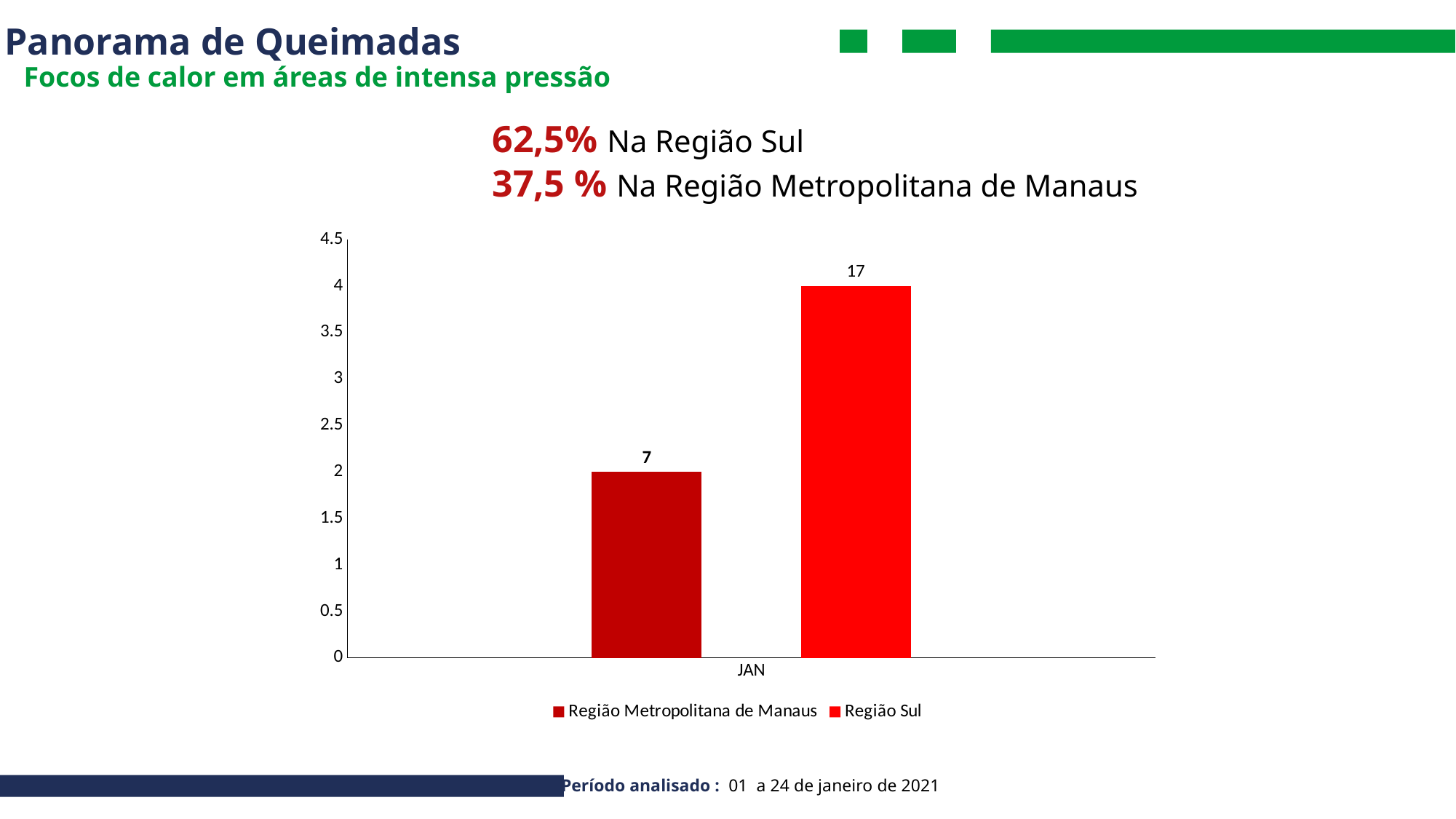
What is the highest value shown on the y axis? 4.5 What is the data label for Região Metropolitana de Manaus in JAN? 7 Which series has the higher bar in JAN? Região Sul What is the data label for Região Sul in JAN? 17 Is the bar for Região Sul larger or smaller than the bar for Região Metropolitana de Manaus? larger How many series does the legend list? 2 How many categories are shown on the x axis? 1 What is the label of the category on the x axis? JAN What is the difference between the data labels for Região Sul and Região Metropolitana de Manaus? 10 Which series has the lower bar in JAN? Região Metropolitana de Manaus What kind of chart is shown on the slide? bar chart